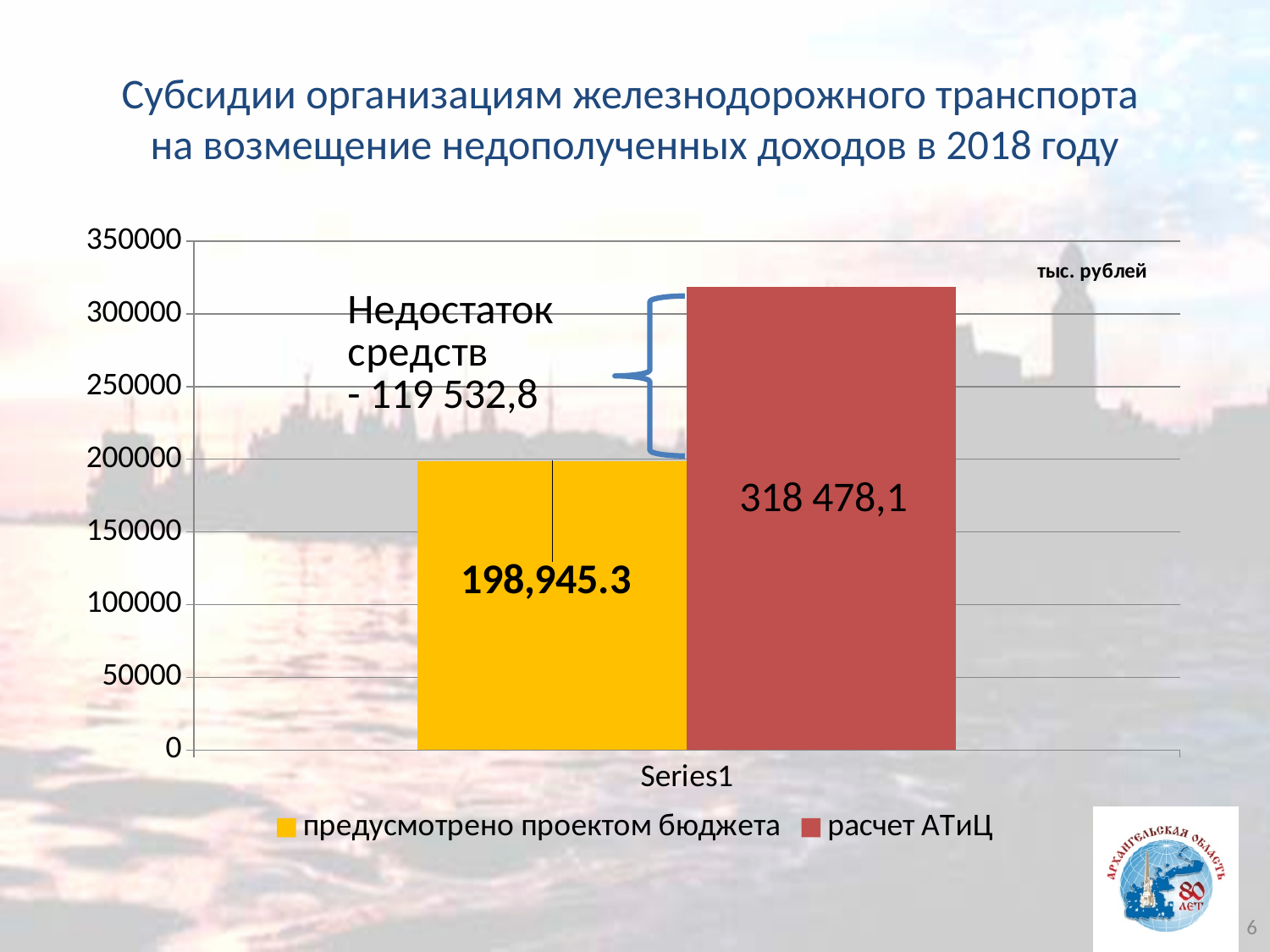
Is the value for 'предусмотрено проектом бюджета' greater or less than 200000? less What is the shortfall ('Недостаток средств') shown between the two bars? 119 532,8 What kind of chart is shown on the slide? bar chart What value is shown for the series 'расчет АТиЦ'? 318 478,1 Which series has the higher value, 'предусмотрено проектом бюджета' or 'расчет АТиЦ'? расчет АТиЦ What unit of measurement is indicated on the chart? тыс. рублей Which series has the highest value on the chart? расчет АТиЦ How many series does the legend list? 2 Is the value for 'расчет АТиЦ' greater or less than 300000? greater What colour is the bar for 'расчет АТиЦ'? red Which series has the lowest value on the chart? предусмотрено проектом бюджета What value is shown for the series 'предусмотрено проектом бюджета'? 198,945.3